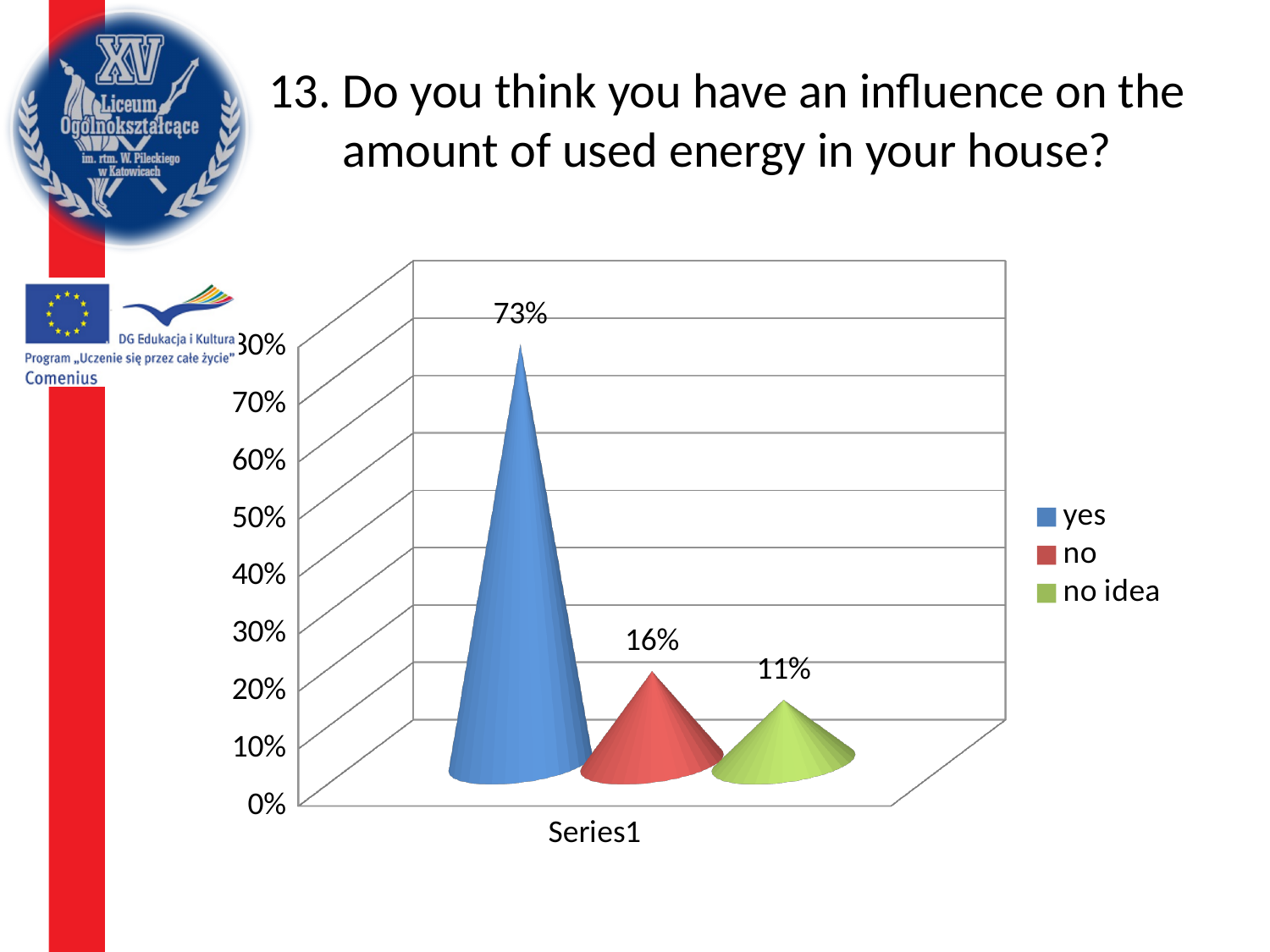
What percentage of respondents answered "no idea"? 11% What is the difference in percentage points between "no" and "no idea"? 5 What kind of chart is shown on the slide? bar chart Which answer has the lowest percentage? no idea How many series does the legend list? 3 What is the difference in percentage points between "yes" and "no"? 57 Which answer has the highest percentage? yes Which is larger, the value for "no" or the value for "no idea"? no What percentage of respondents answered "yes"? 73% What percentage of respondents answered "no"? 16% What colour represents the "no idea" answer in the legend? green Is the value for "yes" greater or less than 50%? greater